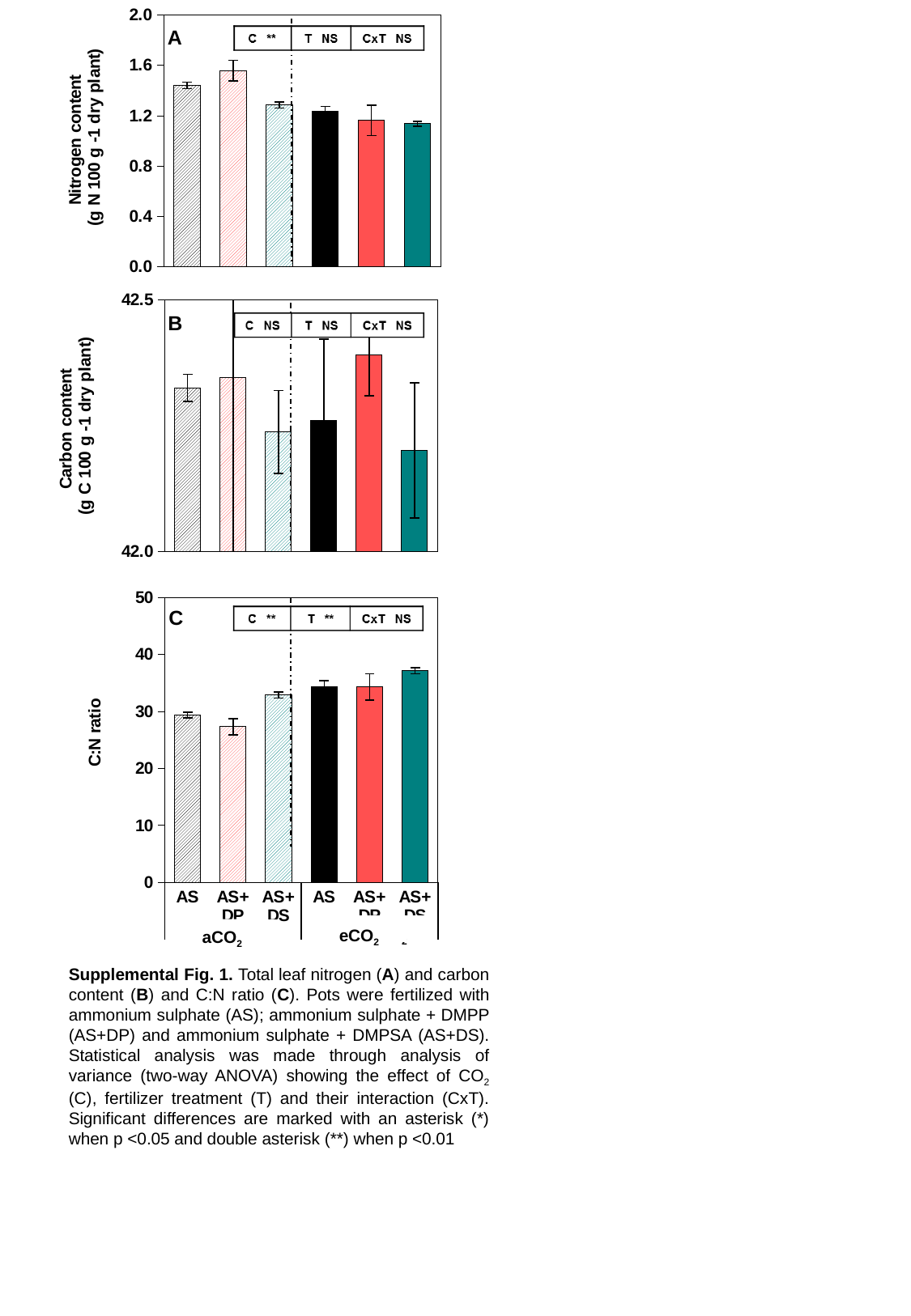
In panel C (C:N ratio), is the value for AS+DP under aCO2 greater or less than 30? less In panel C (C:N ratio), which bar is the highest? AS+DS under eCO2 In panel A (Nitrogen content), is the value for AS under aCO2 greater or less than 1.2? greater What kind of chart is panel A (Nitrogen content)? bar chart In panel A (Nitrogen content), which is larger: AS under aCO2 or AS under eCO2? AS under aCO2 In panel A (Nitrogen content), what significance result is shown for the CO2 effect (C) in the box at the top? ** In panel C (C:N ratio), which bar is the lowest? AS+DP under aCO2 In panel C (C:N ratio), is the value for AS+DS under eCO2 greater or less than 30? greater In panel B (Carbon content), which bar is the highest? AS+DP under eCO2 In panel A (Nitrogen content), which bar is the highest? AS+DP under aCO2 In panel A (Nitrogen content), how many bars are plotted? 6